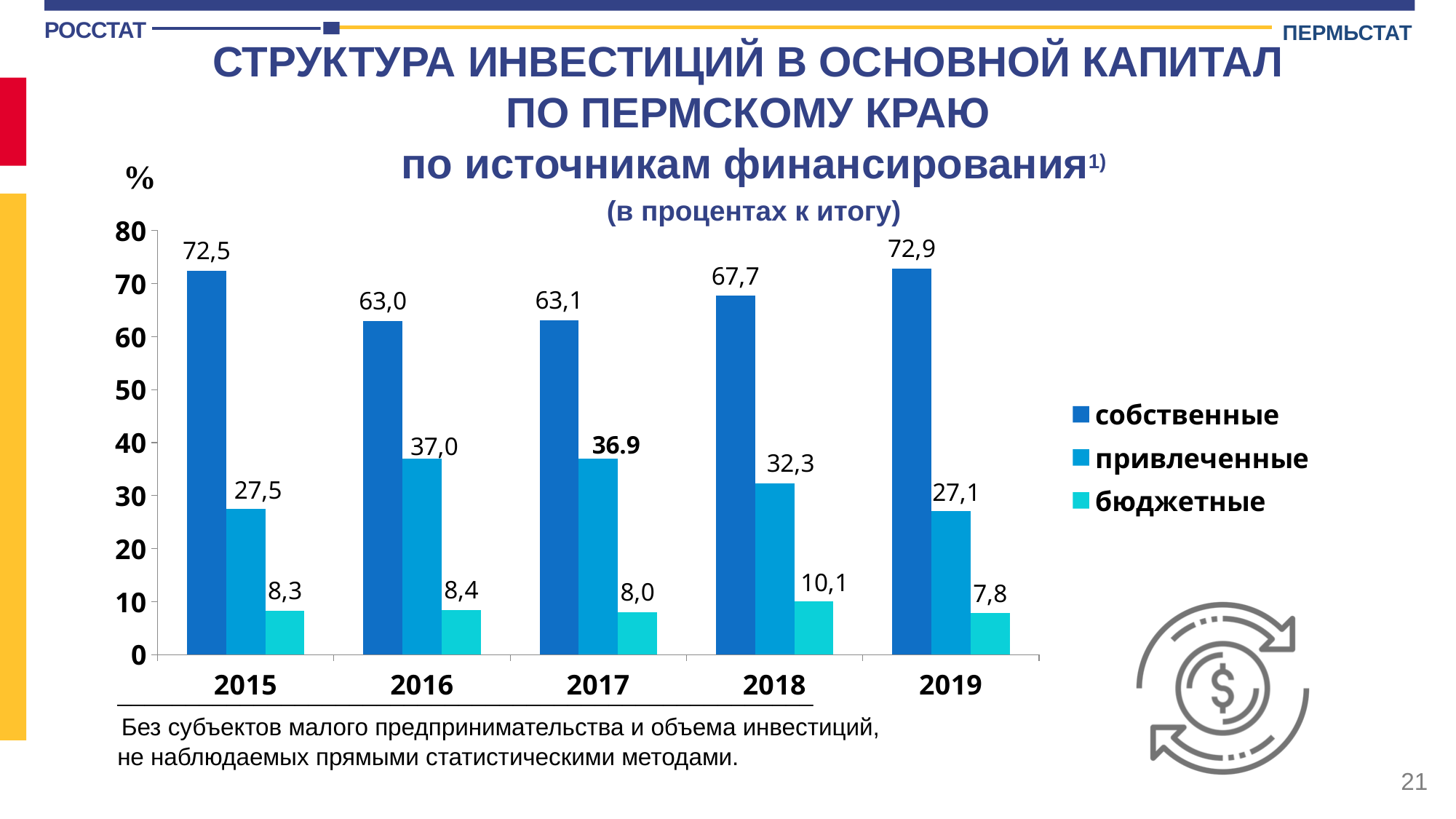
What kind of chart is shown on the slide? bar chart Which legend entry is shown in the lightest (cyan) colour? бюджетные What is the value for привлеченные in 2017? 36.9 What is the difference between the собственные values in 2019 and 2018? 5,2 What is the value for собственные in 2015? 72,5 What is the value for привлеченные in 2018? 32,3 Which is larger in 2016: привлеченные or бюджетные? привлеченные In which year is the value for бюджетные lowest? 2019 How many years are shown on the x axis? 5 In which year is the value for собственные highest? 2019 How many series does the legend list? 3 What is the value for бюджетные in 2019? 7,8